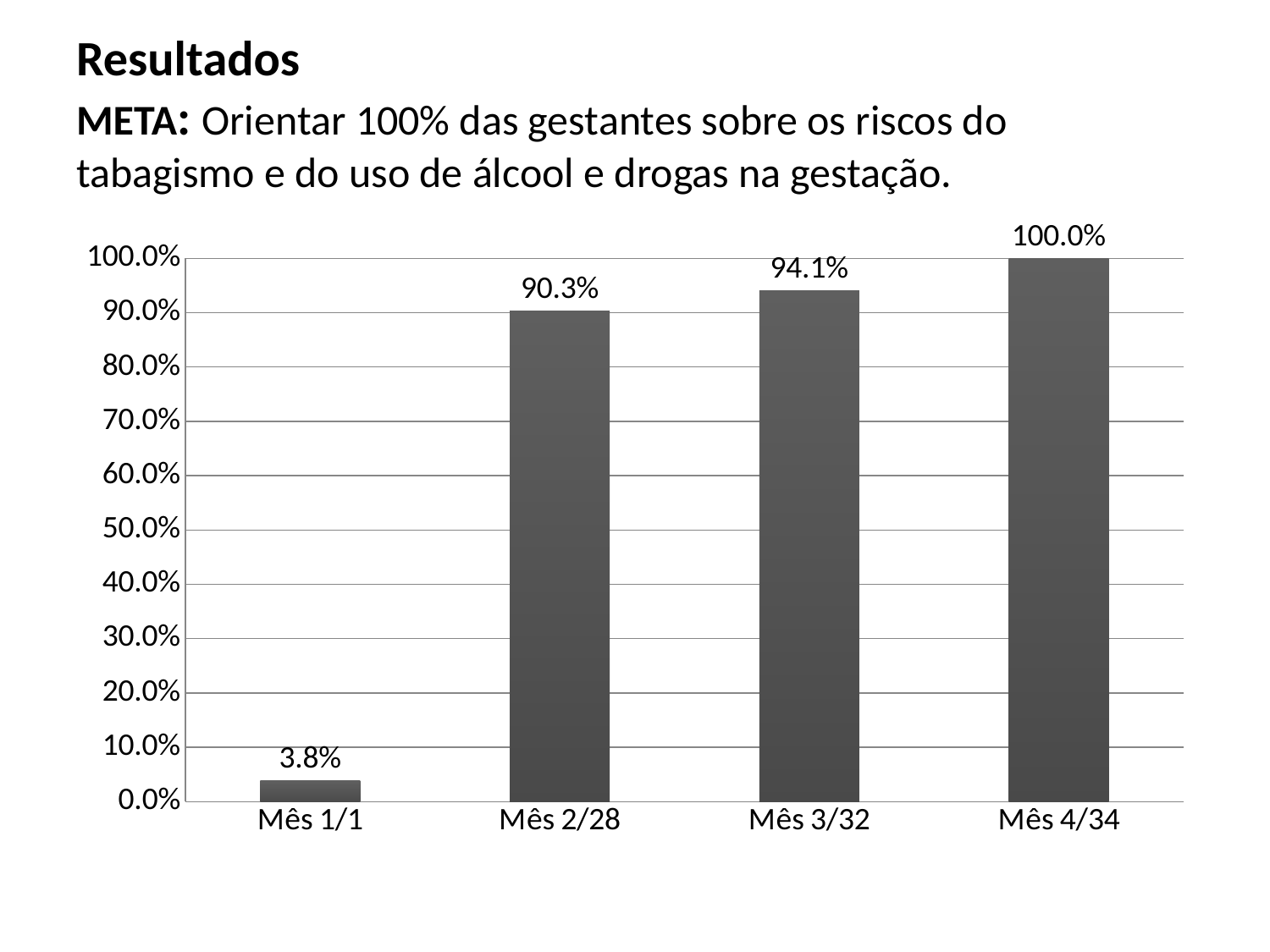
What is the difference between the values for Mês 2/28 and Mês 1/1? 86.5% What kind of chart is shown on the slide? Bar chart What is the value for Mês 1/1? 3.8% What is the difference between the values for Mês 4/34 and Mês 3/32? 5.9% What is the value for Mês 4/34? 100.0% What is the value for Mês 2/28? 90.3% Which is larger, the value for Mês 2/28 or the value for Mês 3/32? Mês 3/32 Which category has the lowest value? Mês 1/1 What is the value for Mês 3/32? 94.1% How many categories are shown on the x axis? 4 Do the values rise or fall from Mês 1/1 to Mês 4/34? Rise Which category has the highest value? Mês 4/34